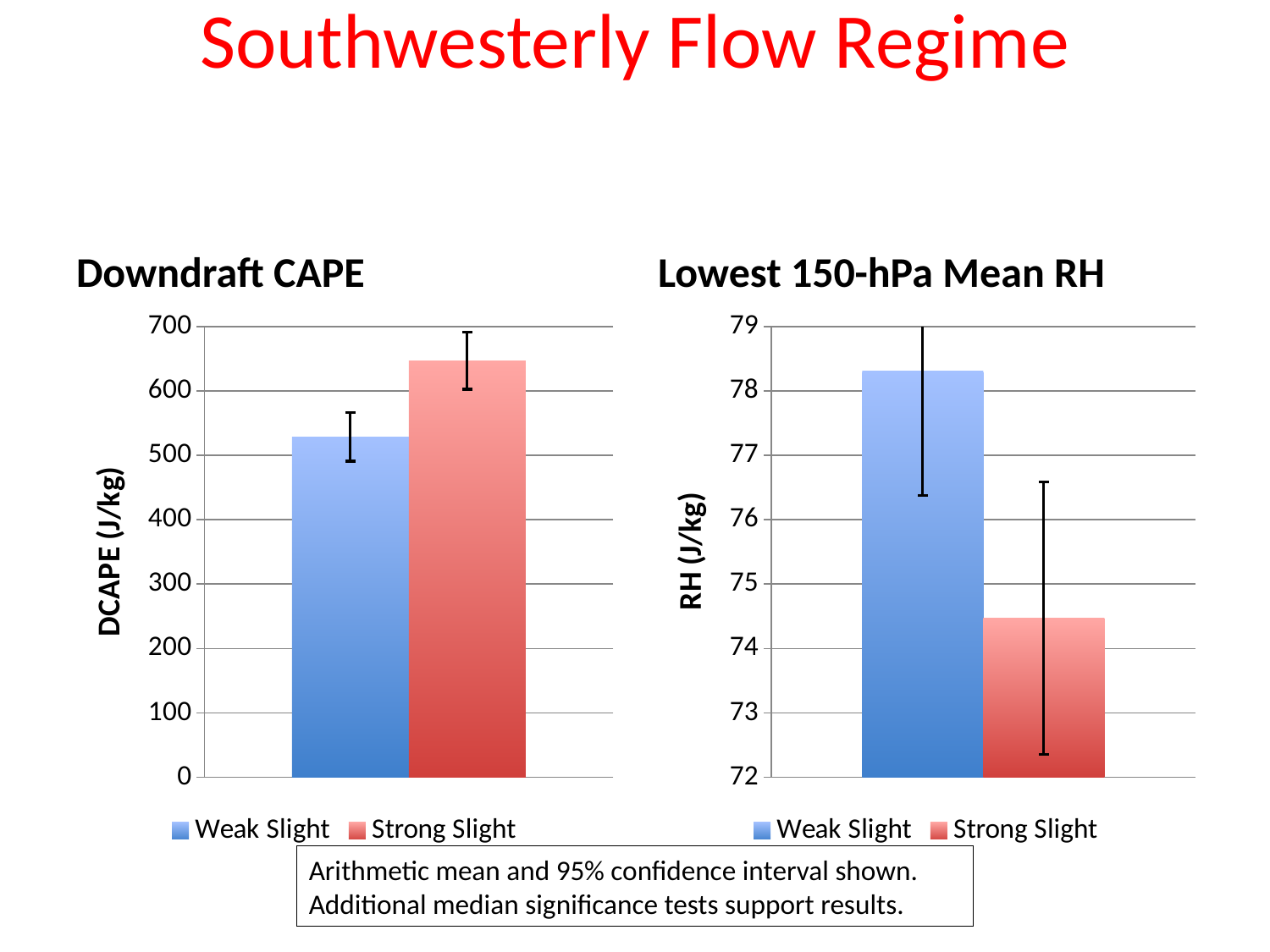
In the Lowest 150-hPa Mean RH chart, which series has the higher value, Weak Slight or Strong Slight? Weak Slight In the Lowest 150-hPa Mean RH chart, is the value for Weak Slight greater or less than 78? greater In the Downdraft CAPE chart, which series has the higher value, Weak Slight or Strong Slight? Strong Slight What kind of chart is the Lowest 150-hPa Mean RH chart? bar chart In the Downdraft CAPE chart, is the value for Weak Slight greater or less than 500? greater What is the y-axis label of the Downdraft CAPE chart? DCAPE (J/kg) In the Lowest 150-hPa Mean RH chart, which series has the lowest value? Strong Slight In the Lowest 150-hPa Mean RH chart, is the value for Strong Slight greater or less than 75? less What colour is the Strong Slight series in the Lowest 150-hPa Mean RH chart? red How many series does the legend of the Downdraft CAPE chart list? 2